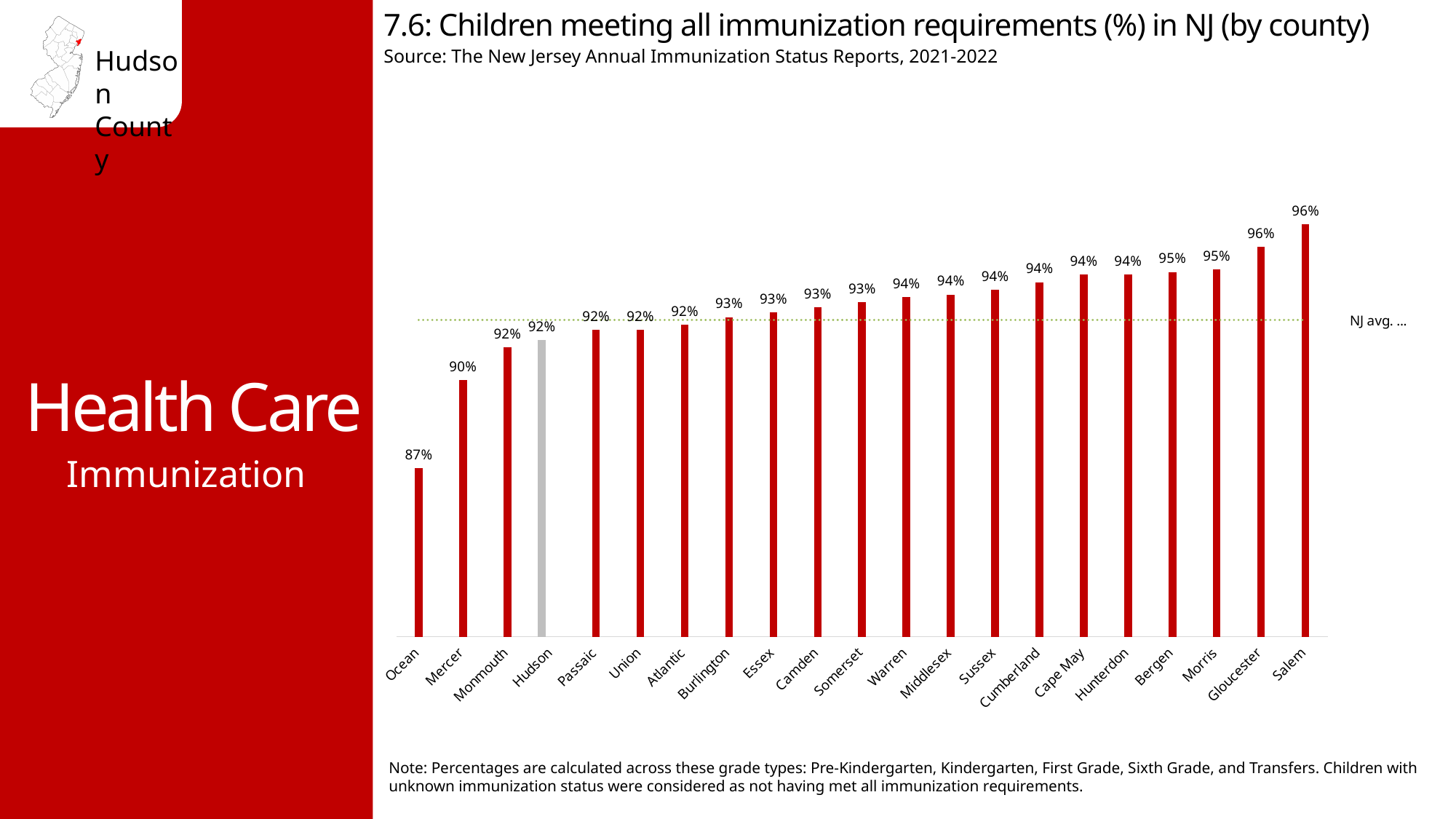
Which county's bar is shown in grey instead of red? Hudson What is the difference in percentage points between Hudson and Ocean counties? 5 percentage points What is the value shown for Mercer County? 90% How many counties are shown in the chart? 21 What is the value shown for Bergen County? 95% Which county has the lowest percentage of children meeting all immunization requirements? Ocean What kind of chart is used on this slide? Bar chart What is the difference in percentage points between Salem and Ocean counties? 9 percentage points What is the value shown for Salem County? 96% What percentage of children in Hudson County met all immunization requirements? 92% Which county has a higher value, Mercer or Ocean? Mercer What is the value shown for Ocean County? 87%